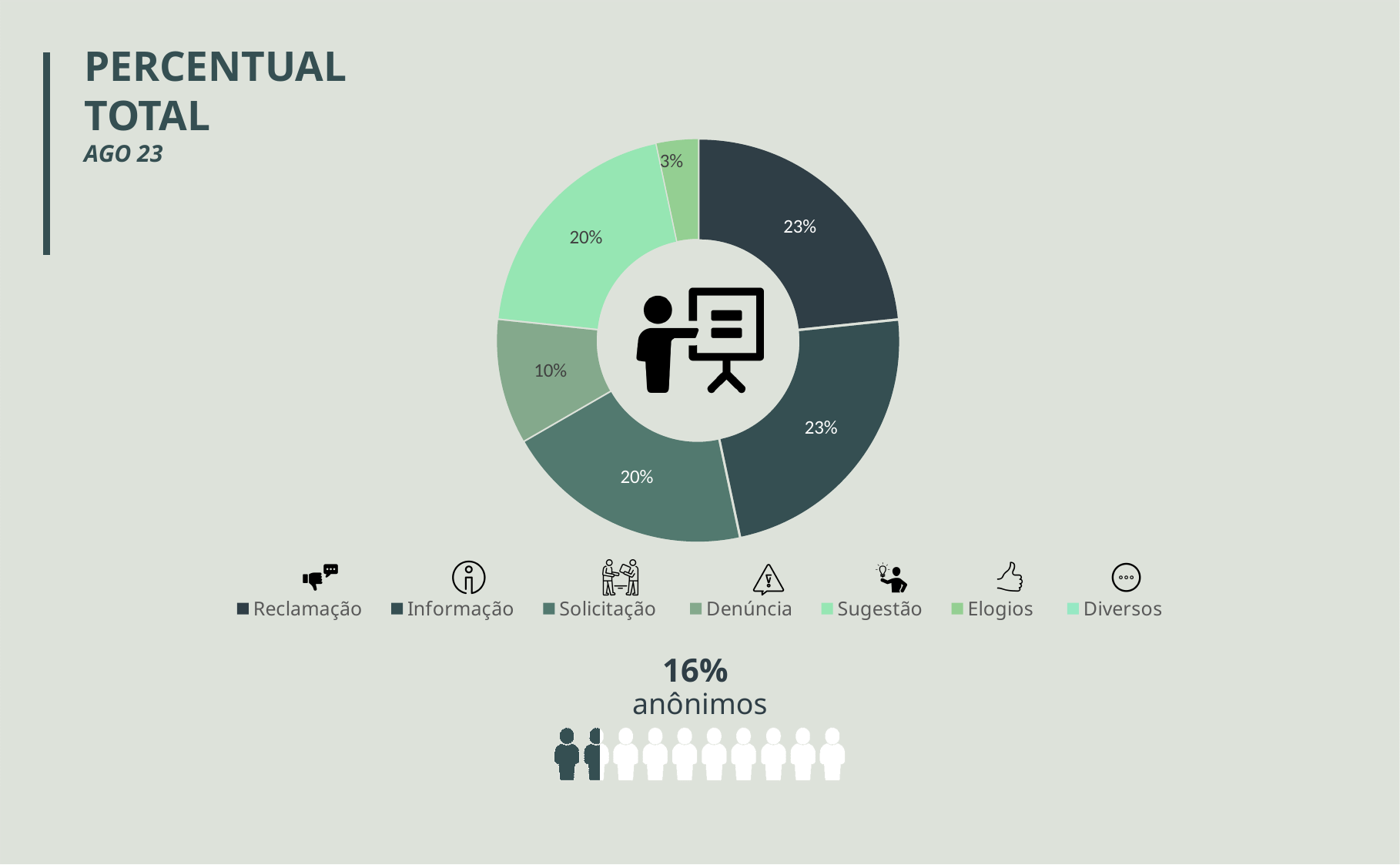
What percentage does the Sugestão slice show? 20% What percentage does the Informação slice show? 23% Which slice is larger, Sugestão or Elogios? Sugestão How many categories does the legend list? 7 What percentage does the Reclamação slice show? 23% What kind of chart is shown on the slide? pie (donut) chart Which slice is larger, Denúncia or Solicitação? Solicitação What percentage does the Denúncia slice show? 10% What percentage does the Solicitação slice show? 20% How many percentage points larger is the Reclamação slice than the Denúncia slice? 13 percentage points What percentage does the Elogios slice show? 3% What is the title of the chart on the slide? PERCENTUAL TOTAL